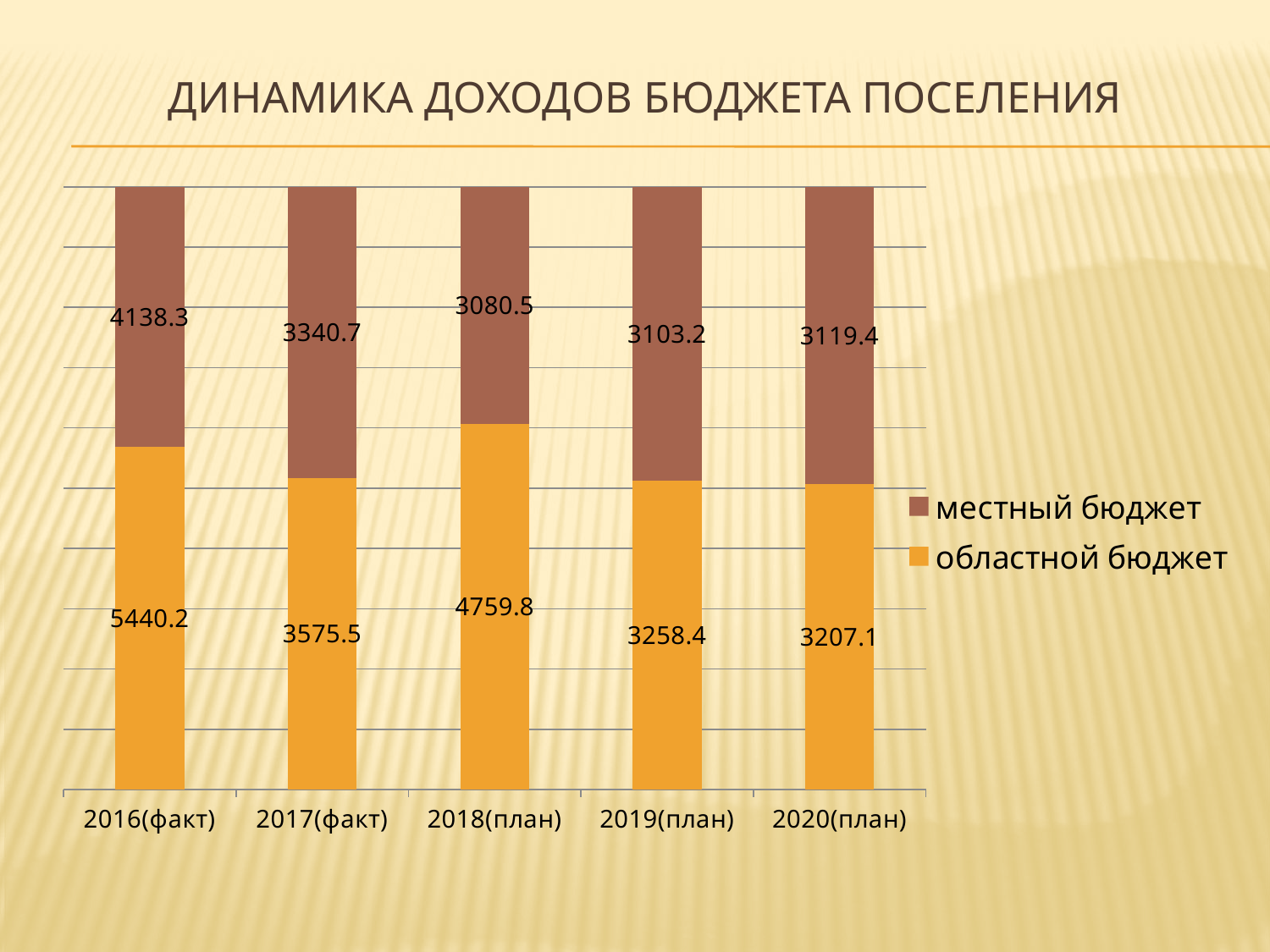
Which year has the lowest value for областной бюджет? 2020(план) Which year has the highest value for местный бюджет? 2016(факт) What is the value of местный бюджет for 2017(факт)? 3340.7 What is the value of областной бюджет for 2016(факт)? 5440.2 What is the difference between областной бюджет and местный бюджет in 2018(план)? 1679.3 What is the total of the two series for 2016(факт)? 9578.5 How many series does the legend list? 2 What is the value of местный бюджет for 2018(план)? 3080.5 Which is larger in 2019(план): областной бюджет or местный бюджет? областной бюджет How many years are shown on the x axis? 5 Which year has the highest value for областной бюджет? 2016(факт) What is the value of областной бюджет for 2020(план)? 3207.1